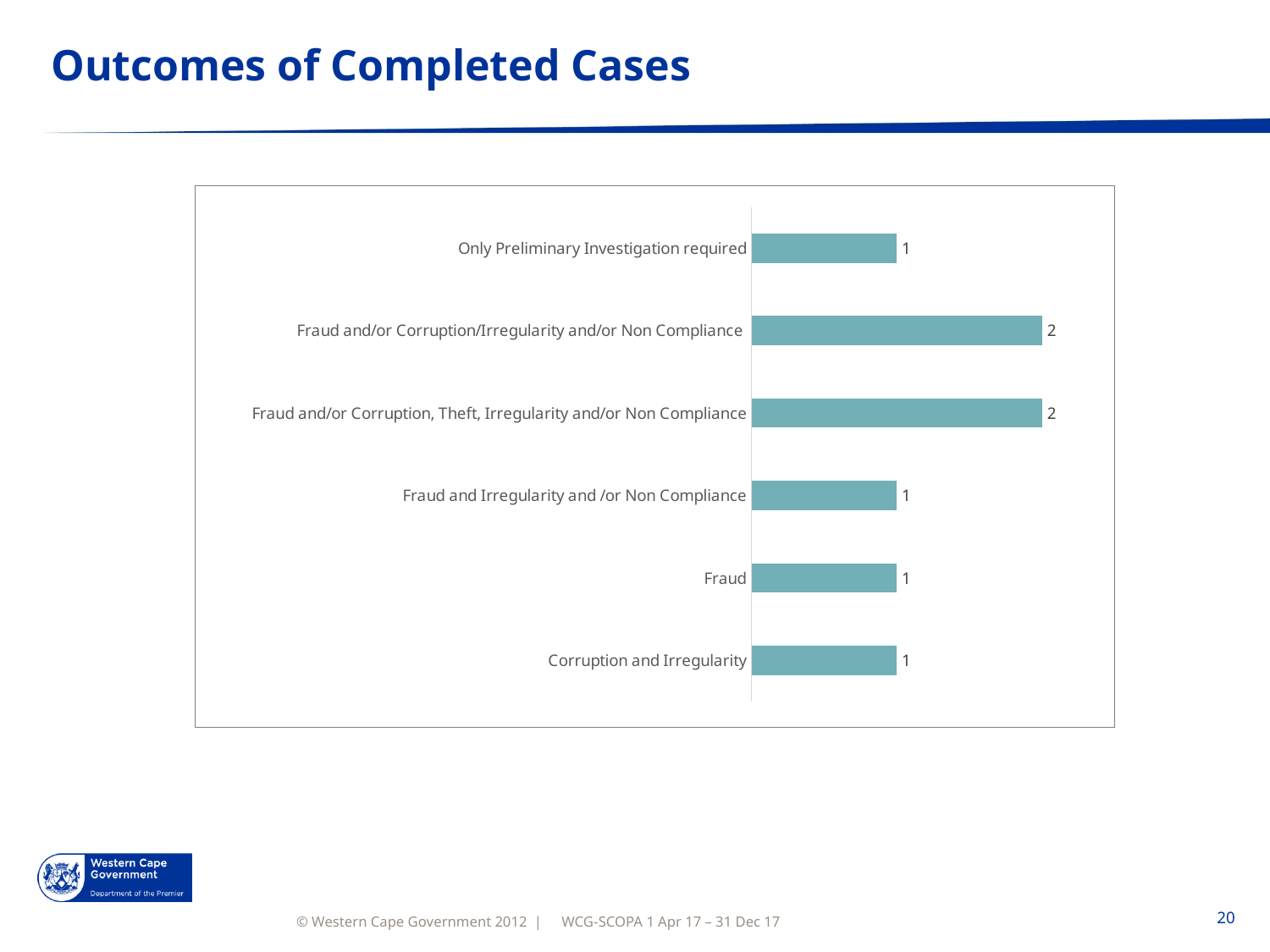
What is the difference between the value for Fraud and/or Corruption/Irregularity and/or Non Compliance and the value for Fraud? 1 Which is larger, the value for Fraud and/or Corruption, Theft, Irregularity and/or Non Compliance or the value for Corruption and Irregularity? Fraud and/or Corruption, Theft, Irregularity and/or Non Compliance What is the value for Fraud? 1 What kind of chart is shown on the slide? Bar chart What is the value for Fraud and/or Corruption, Theft, Irregularity and/or Non Compliance? 2 What is the title of the slide? Outcomes of Completed Cases What is the total of all the values shown in the chart? 8 What is the value for Fraud and/or Corruption/Irregularity and/or Non Compliance? 2 What is the value for Only Preliminary Investigation required? 1 What is the value for Corruption and Irregularity? 1 How many categories are shown in the chart? 6 How many categories have a value of 2? 2